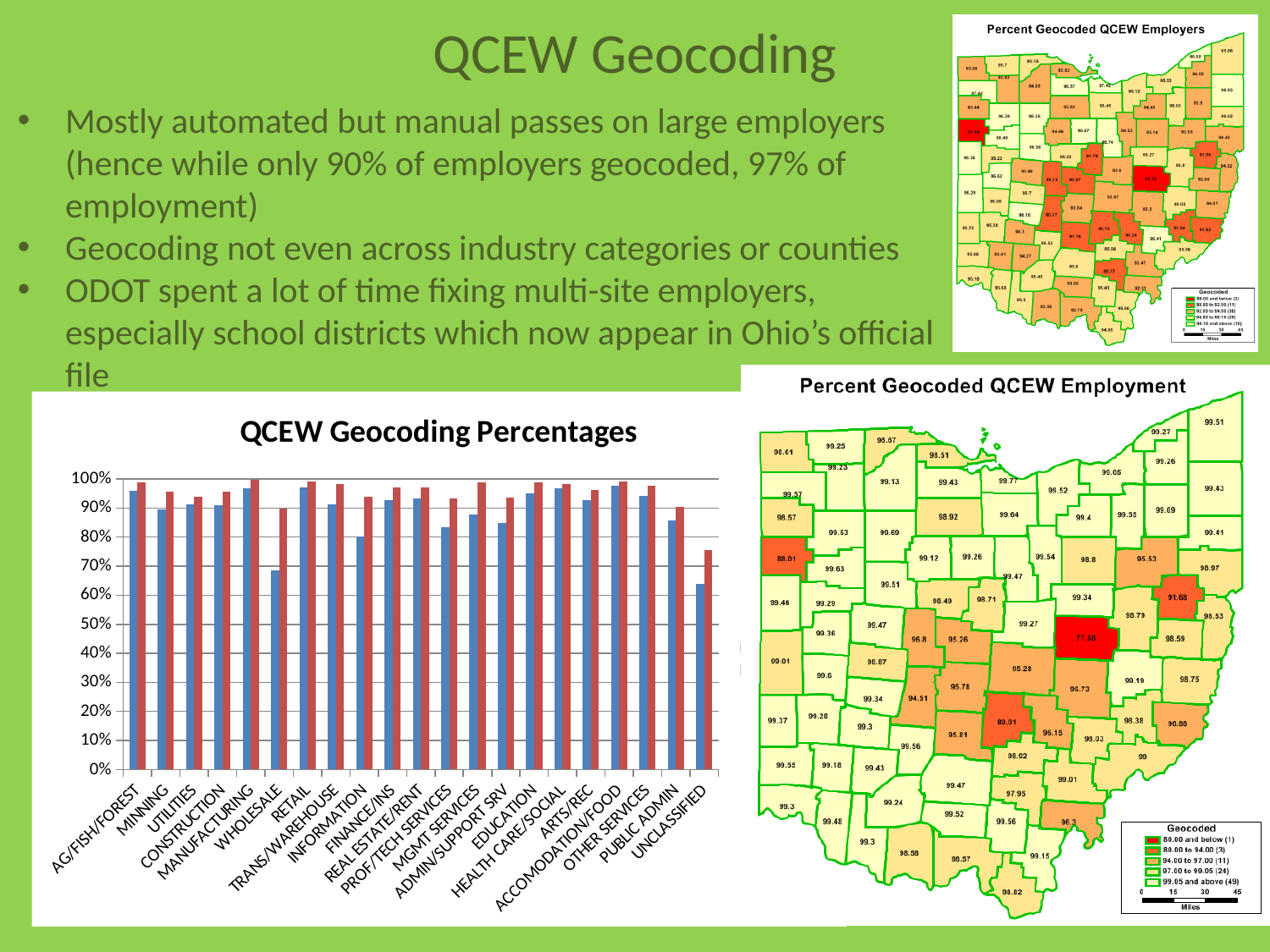
In the 'QCEW Geocoding Percentages' chart, how many bars are plotted for each industry category? 2 In the 'QCEW Geocoding Percentages' chart, which is larger for WHOLESALE, the blue bar or the red bar? the red bar In the 'QCEW Geocoding Percentages' chart, is the blue bar for EDUCATION greater or less than 90%? greater In the 'QCEW Geocoding Percentages' chart, is the red bar for UNCLASSIFIED greater or less than 70%? greater What kind of chart is 'QCEW Geocoding Percentages'? bar chart In the 'QCEW Geocoding Percentages' chart, which category has the larger blue bar, WHOLESALE or RETAIL? RETAIL In the 'QCEW Geocoding Percentages' chart, is the blue bar for WHOLESALE greater or less than 80%? less In the 'QCEW Geocoding Percentages' chart, which category has the lowest red bar? UNCLASSIFIED How many industry categories are shown on the x axis of the 'QCEW Geocoding Percentages' chart? 21 What is the title of the bar chart at the bottom left of the slide? QCEW Geocoding Percentages